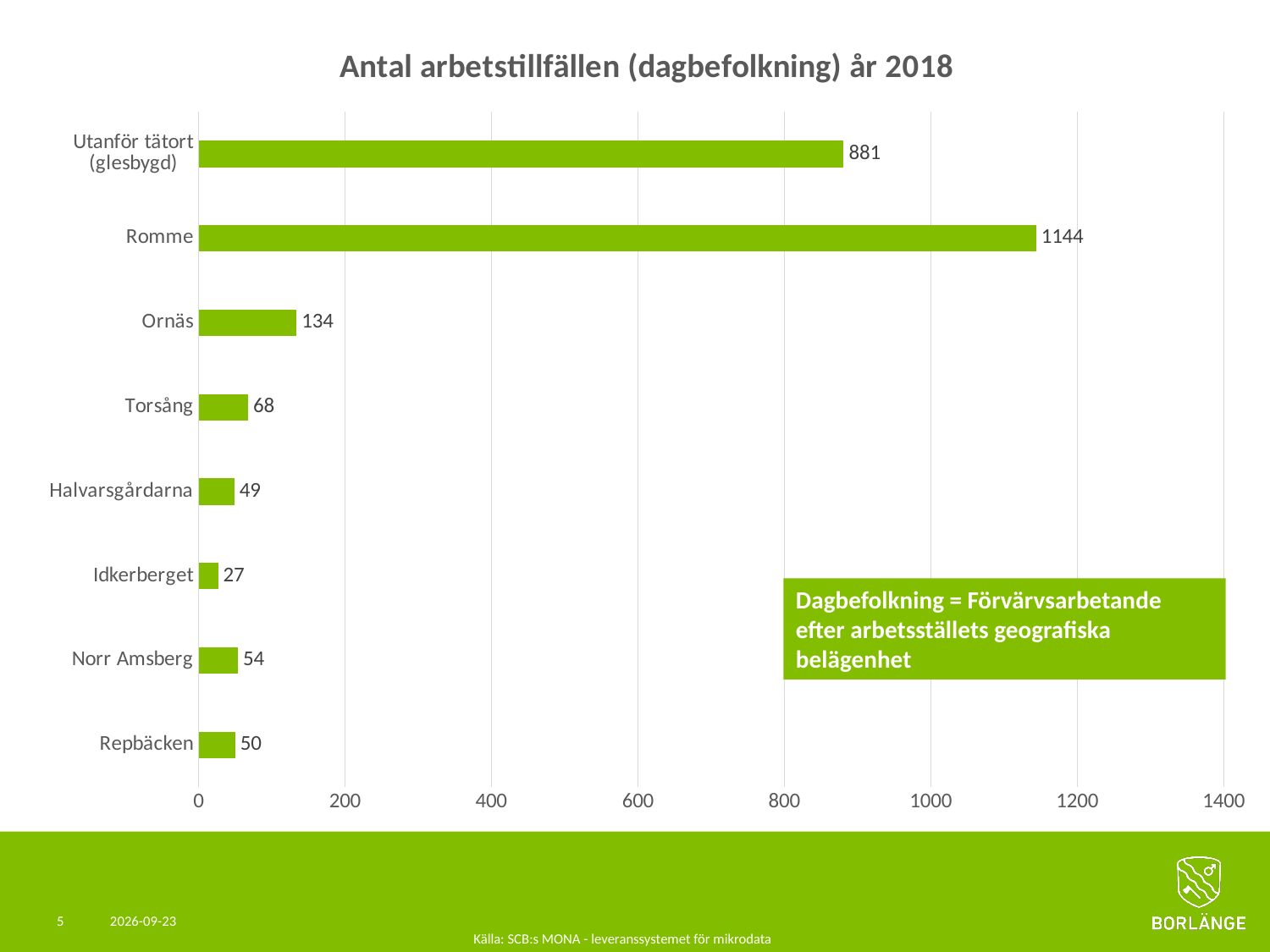
What is the value for Utanför tätort (glesbygd)? 881 Which is larger, the value for Norr Amsberg or the value for Repbäcken? Norr Amsberg What is the value for Ornäs? 134 Which category has the highest value? Romme What is the title of the chart? Antal arbetstillfällen (dagbefolkning) år 2018 What is the difference between the values for Torsång and Halvarsgårdarna? 19 What is the difference between the values for Romme and Utanför tätort (glesbygd)? 263 What is the value for Romme? 1144 What kind of chart is this? Bar chart Which category has the lowest value? Idkerberget What is the value for Idkerberget? 27 How many categories are shown in the chart? 8